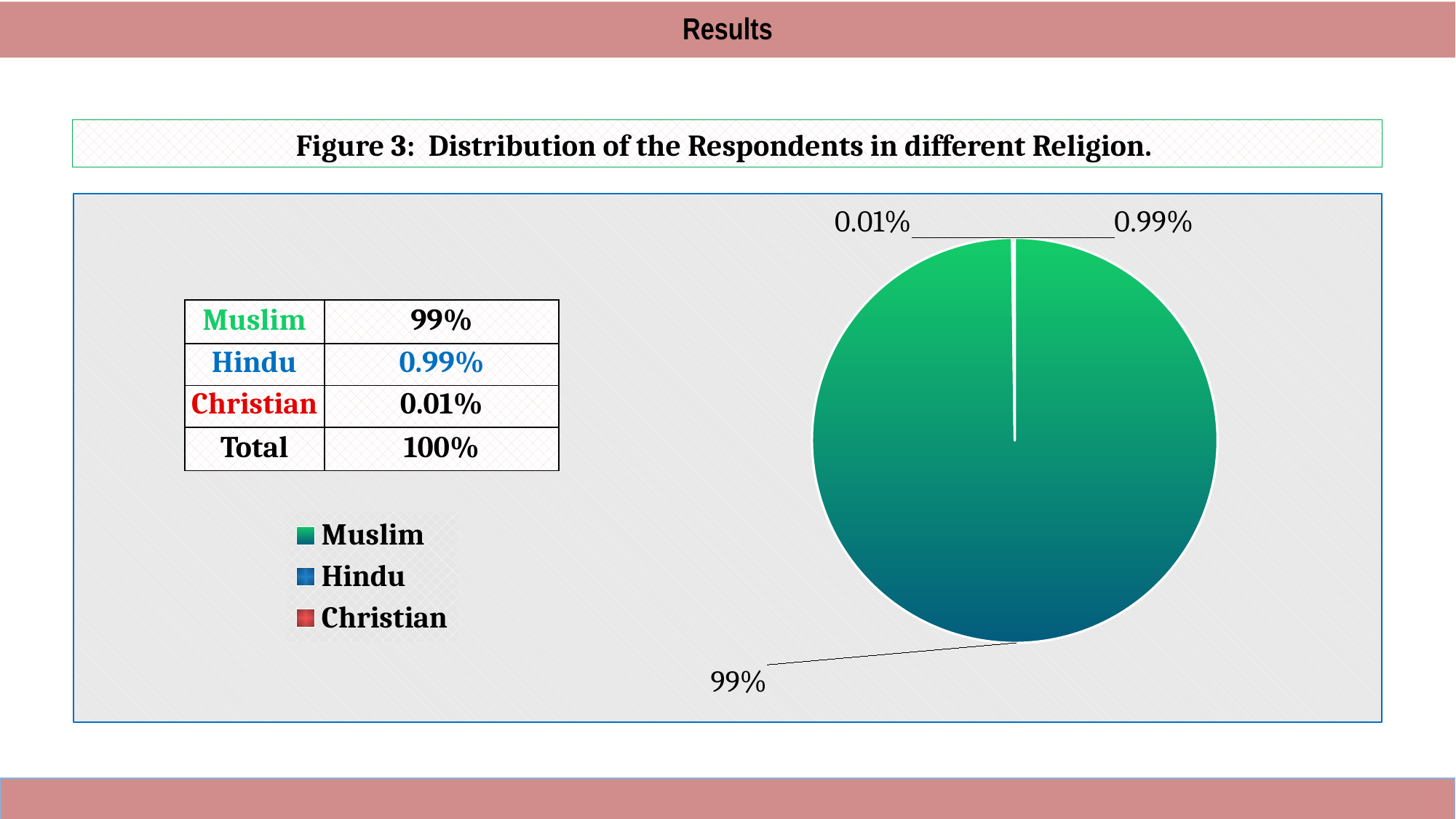
What percentage of respondents are Christian? 0.01% What percentage of respondents are Muslim? 99% What is the title of the figure? Figure 3: Distribution of the Respondents in different Religion. What colour represents Christian in the legend? red What is the difference between the Muslim share and the Hindu share? 98.01% Which religion has the largest share of respondents? Muslim How many religion categories does the legend list? 3 Which is larger, the share for Hindu or the share for Christian? Hindu Which religion has the smallest share of respondents? Christian What kind of chart is shown on the slide? pie chart What is the total shown in the table for all religions? 100% What percentage of respondents are Hindu? 0.99%